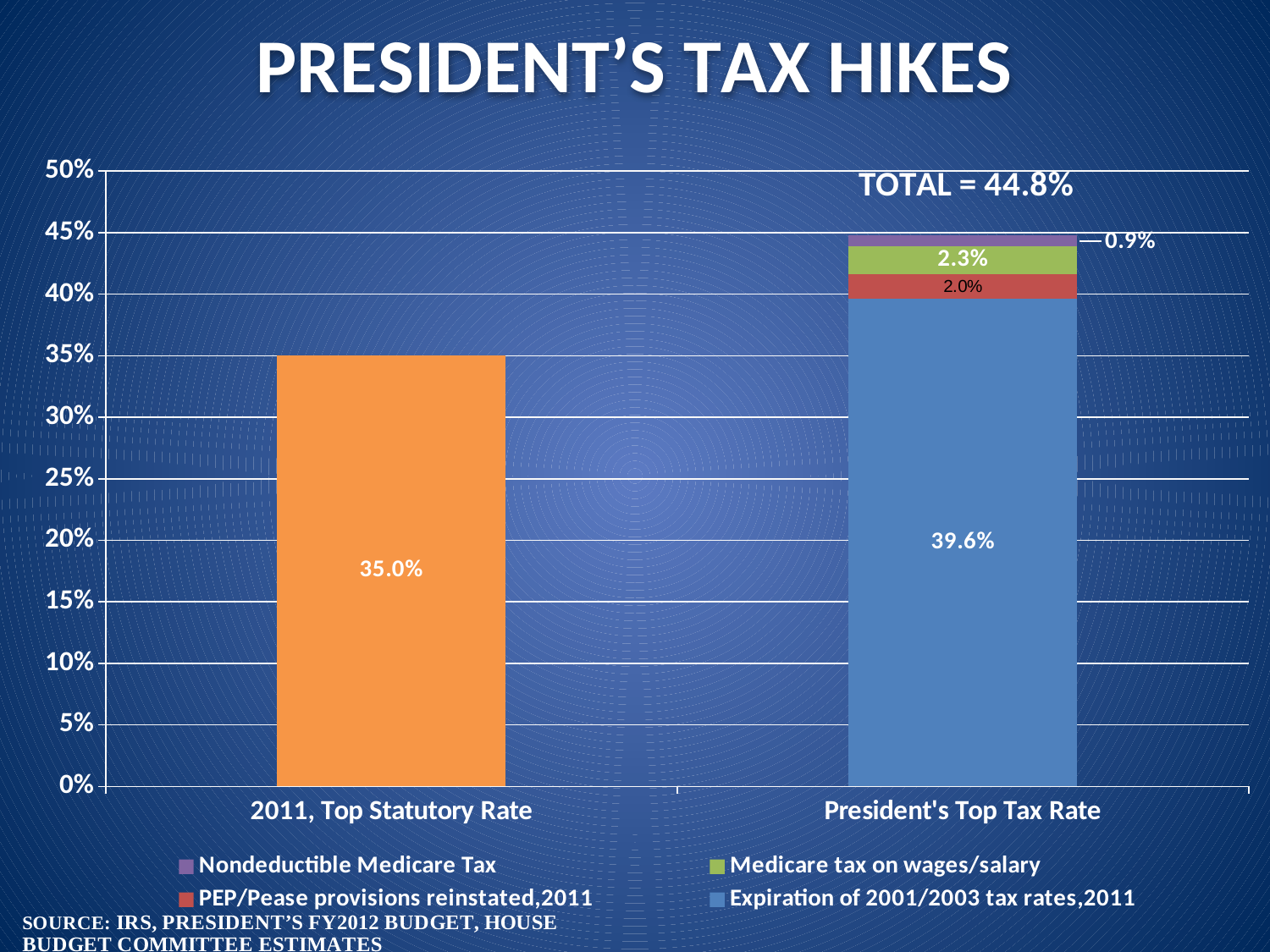
What is the value of the Expiration of 2001/2003 tax rates,2011 segment in the President's Top Tax Rate bar? 39.6% What is the title of the chart? PRESIDENT'S TAX HIKES What is the value of the PEP/Pease provisions reinstated,2011 segment in the President's Top Tax Rate bar? 2.0% What is the value of the Nondeductible Medicare Tax segment in the President's Top Tax Rate bar? 0.9% What is the total of the President's Top Tax Rate stacked bar? 44.8% How many series does the legend list? 4 Which bar is taller, 2011, Top Statutory Rate or President's Top Tax Rate? President's Top Tax Rate How many categories are shown on the x axis? 2 What kind of chart is shown on the slide? Stacked bar chart What is the difference between the total for President's Top Tax Rate and the value for 2011, Top Statutory Rate? 9.8% What is the value shown for 2011, Top Statutory Rate? 35.0% What is the value of the Medicare tax on wages/salary segment in the President's Top Tax Rate bar? 2.3%